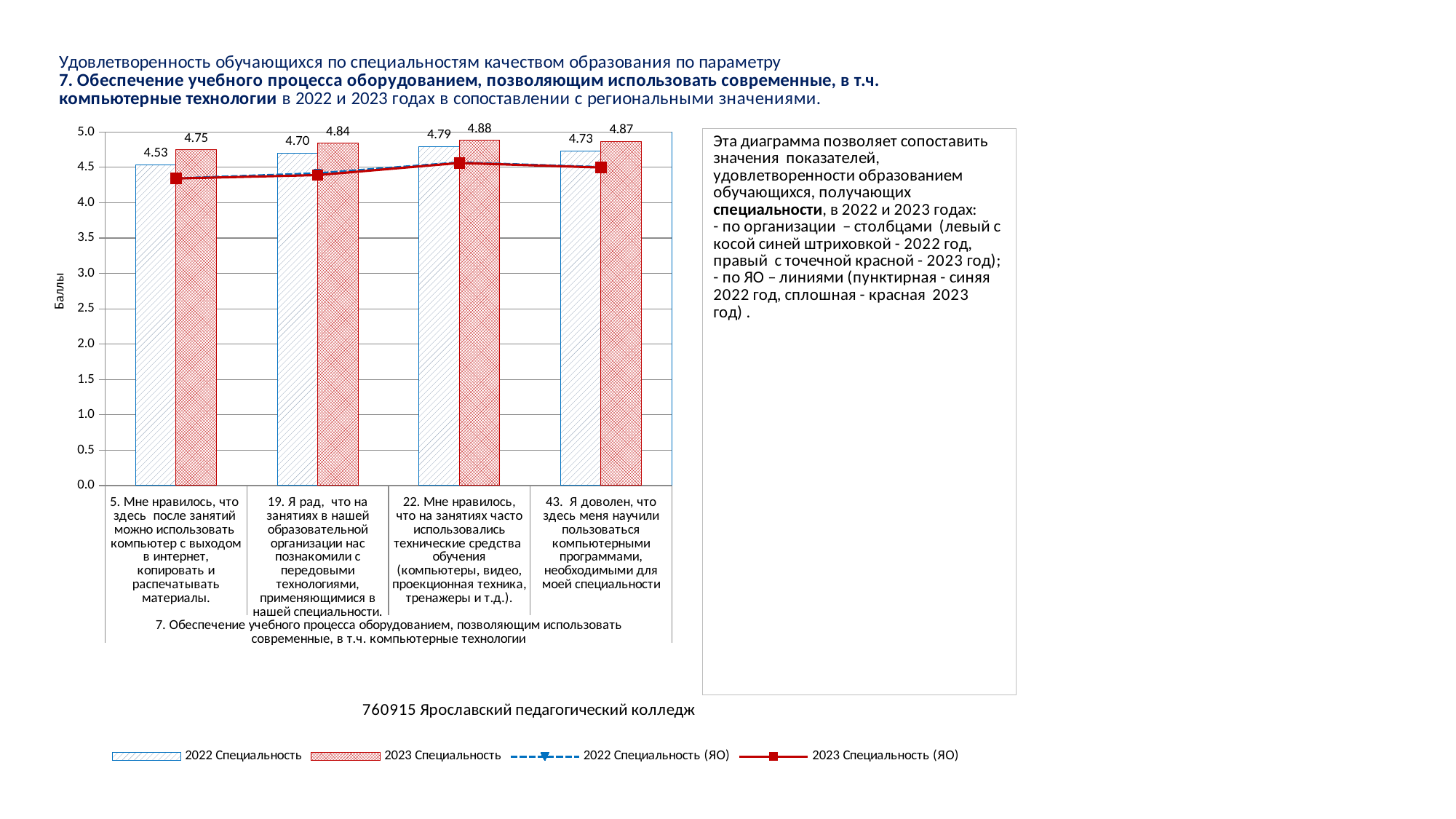
How many categories (survey items) are shown on the x axis? 4 What kind of chart is this? Combined bar and line chart What is the label of the vertical axis? Баллы Is the value of the 2023 Специальность (ЯО) line for item 5 greater or less than 4.5? less Which item has the lowest 2023 Специальность bar? 5. Мне нравилось, что здесь после занятий можно использовать компьютер с выходом в интернет What is the value of the 2022 Специальность bar for item 5 ("Мне нравилось, что здесь после занятий можно использовать компьютер...")? 4.53 For item 5, which is larger: the 2022 Специальность bar or the 2023 Специальность bar? 2023 Специальность Which item has the highest 2022 Специальность bar? 22. Мне нравилось, что на занятиях часто использовались технические средства обучения What is the difference between the 2023 and 2022 Специальность bars for item 19 ("Я рад, что на занятиях в нашей образовательной организации нас познакомили с передовыми технологиями...")? 0.14 What is the value of the 2023 Специальность bar for item 22 ("Мне нравилось, что на занятиях часто использовались технические средства обучения...")? 4.88 How many series does the legend list? 4 What is the value of the 2023 Специальность bar for item 43 ("Я доволен, что здесь меня научили пользоваться компьютерными программами...")? 4.87